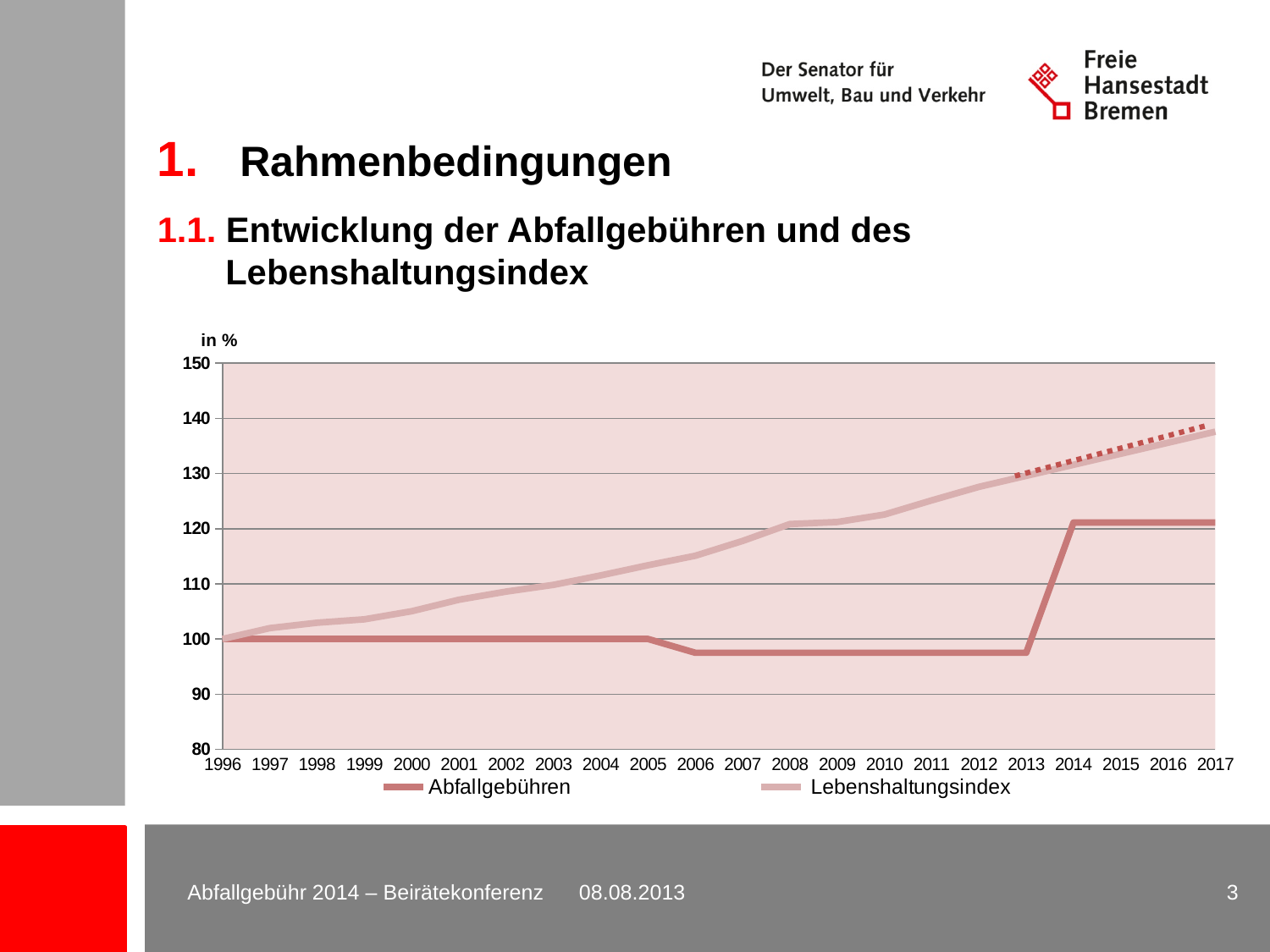
In 2017, which series has the higher value, Abfallgebühren or Lebenshaltungsindex? Lebenshaltungsindex How many years are shown on the x axis? 22 What is the value of Abfallgebühren in 1996? 100 Does the Lebenshaltungsindex rise or fall from 1996 to 2017? rise In which year does the Lebenshaltungsindex reach its highest value? 2017 Is the value for Lebenshaltungsindex in 2017 greater or less than 130? greater Is the value for Abfallgebühren in 2015 greater or less than 110? greater What unit is given for the y axis? in % Is the value for Lebenshaltungsindex in 2008 greater or less than 110? greater What kind of chart is shown on the slide? line chart How many series does the legend list? 2